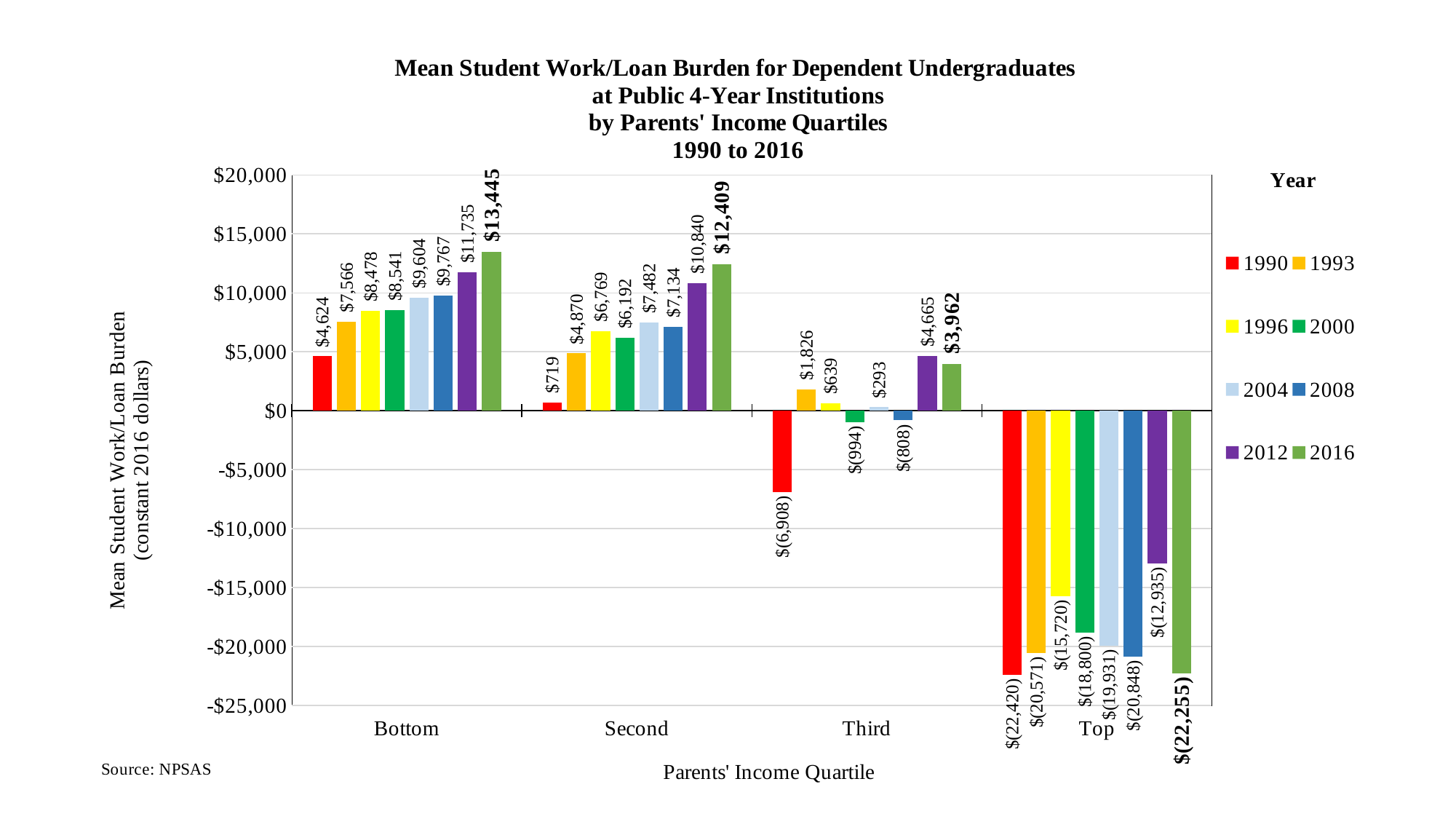
How many parents' income quartile categories are shown on the x axis? 4 What is the value for the Top quartile in 1990? $(22,420) What is the value for the Third quartile in 2012? $4,665 Which parents' income quartile has the highest value for 2016? Bottom How many years does the legend list? 8 What is the difference between the Second quartile's 2016 and 2012 values? $1,569 What is the mean student work/loan burden for the Bottom quartile in 2016? $13,445 Which year has the lowest value for the Third quartile? 1990 What is the difference between the Bottom quartile's 2016 value and its 1990 value? $8,821 Which is larger for 2012: the Bottom quartile or the Second quartile? Bottom What kind of chart is shown on the slide? bar chart Is the value for the Bottom quartile in 2012 greater or less than $10,000? greater